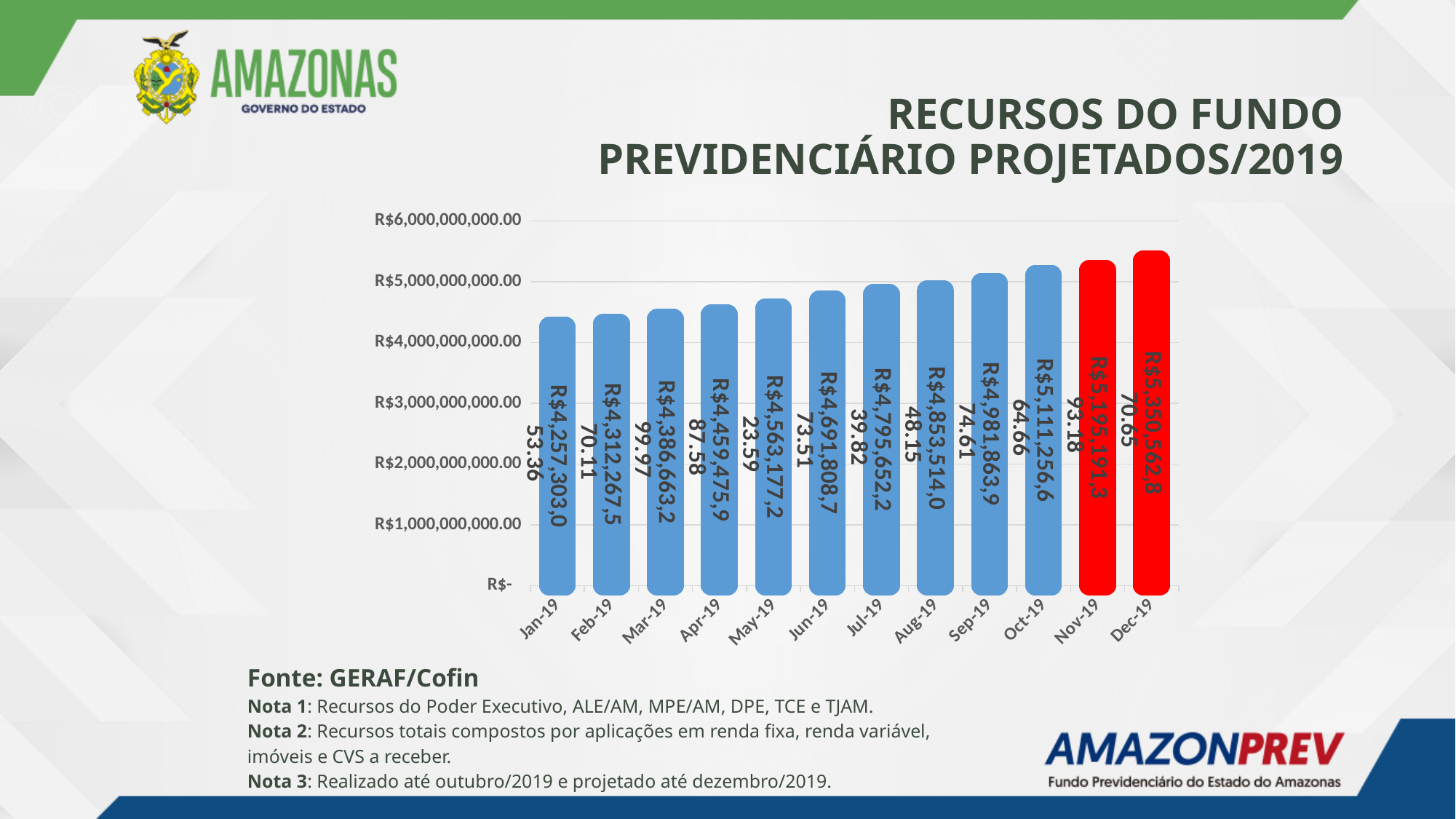
What type of chart is shown on the slide? bar chart Which month has the highest value? Dec-19 How many months are plotted on the chart? 12 What is the value for Jan-19? R$4,257,303,053.36 Which months are shown with red bars instead of blue? Nov-19 and Dec-19 What is the difference between the values for Dec-19 and Jan-19? R$1,093,259,817.29 What is the value for Oct-19? R$5,111,256,664.66 Which month has the lowest value? Jan-19 What is the value for Dec-19? R$5,350,562,870.65 Which is larger, the value for Mar-19 or the value for Sep-19? Sep-19 Is the value for Jun-19 greater or less than R$5,000,000,000.00? less Do the values rise or fall from Jan-19 to Dec-19? rise